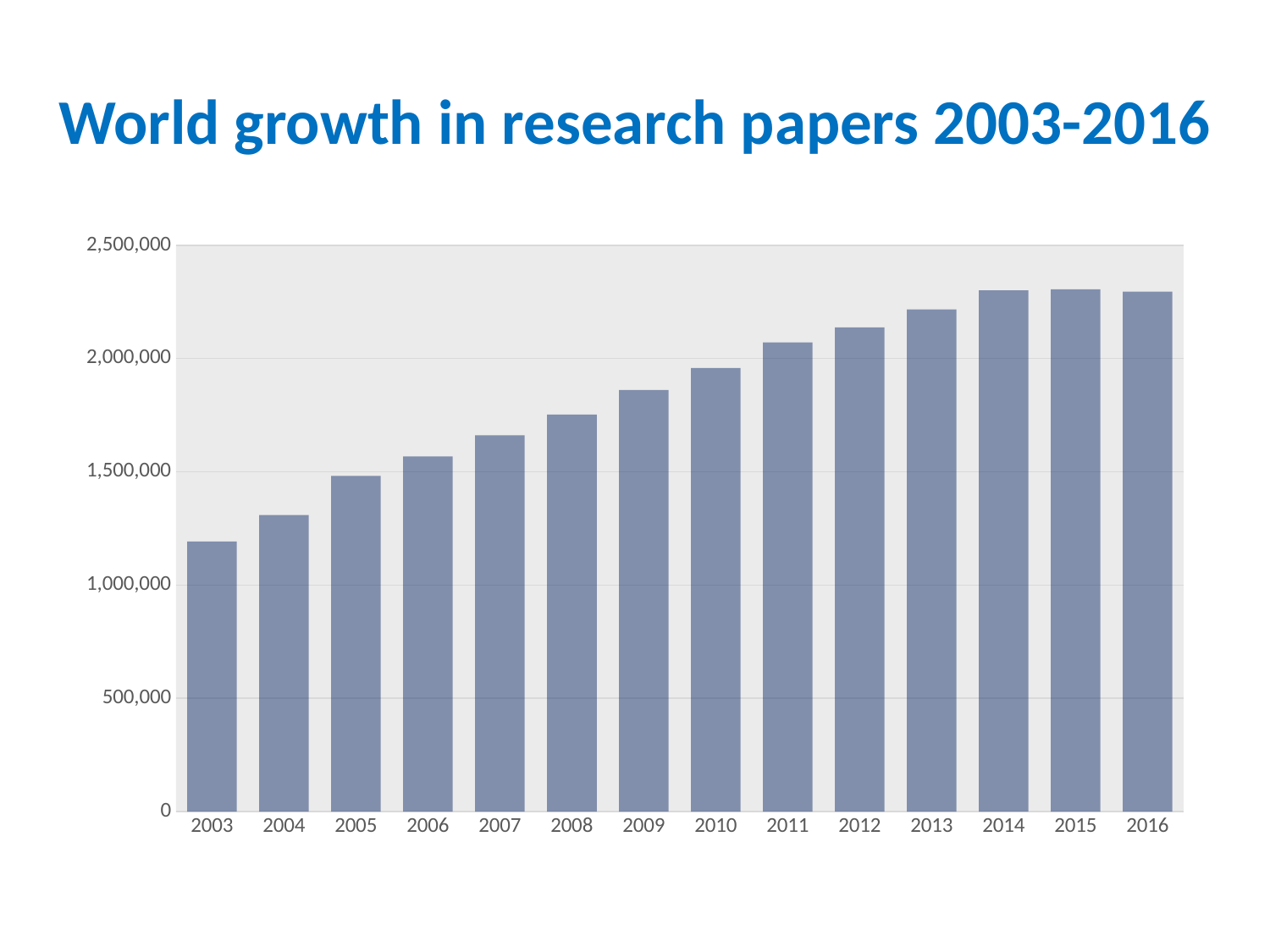
What kind of chart is shown on the slide? bar chart Is the value for 2008 greater or less than 1,500,000? greater Which year has the larger value, 2007 or 2013? 2013 Do the values generally rise or fall from 2003 to 2013? rise Which year has the lowest value in the chart? 2003 How many years are shown on the x axis of the chart? 14 What is the title of the chart? World growth in research papers 2003-2016 Which year has the larger value, 2003 or 2010? 2010 Is the value for 2014 greater or less than 2,500,000? less Is the value for 2004 greater or less than 1,500,000? less